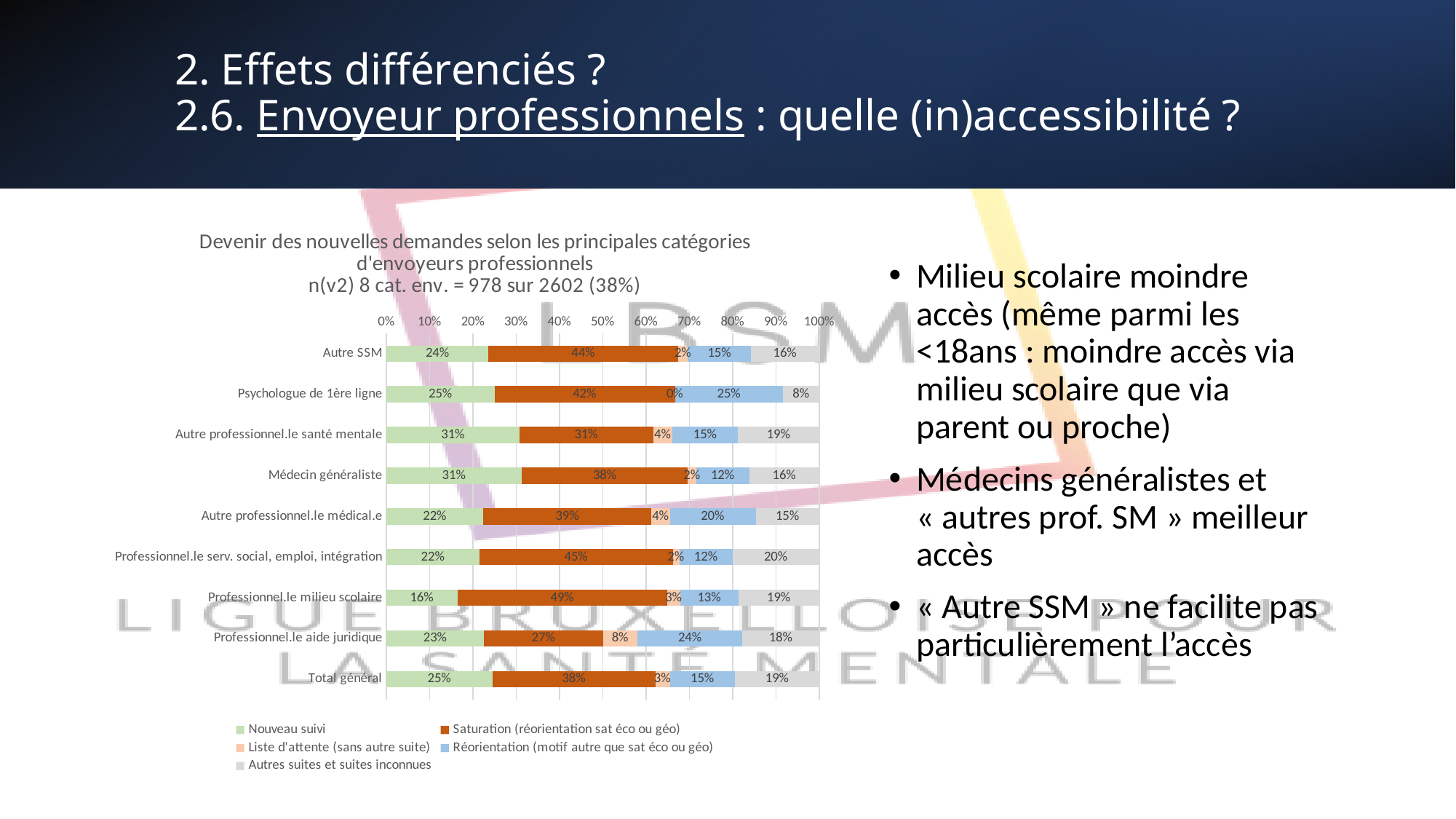
Which has a larger 'Réorientation (motif autre que sat éco ou géo)' share: 'Autre professionnel.le médical.e' or 'Médecin généraliste'? Autre professionnel.le médical.e How many series does the legend list? 5 What is the 'Saturation (réorientation sat éco ou géo)' value for 'Professionnel.le aide juridique'? 27% What is the 'Liste d'attente (sans autre suite)' value for 'Professionnel.le aide juridique'? 8% How many categories (bars) are shown on the chart? 9 Which category has the lowest 'Nouveau suivi' share? Professionnel.le milieu scolaire What type of chart is shown on the slide? Stacked bar chart What is the 'Nouveau suivi' share for 'Total général'? 25% What is the difference between the 'Nouveau suivi' share for 'Médecin généraliste' and for 'Professionnel.le milieu scolaire'? 15% What is the 'Réorientation (motif autre que sat éco ou géo)' value for 'Psychologue de 1ère ligne'? 25% Which category has the highest 'Saturation (réorientation sat éco ou géo)' share? Professionnel.le milieu scolaire What percentage of new requests from 'Professionnel.le milieu scolaire' resulted in 'Nouveau suivi'? 16%